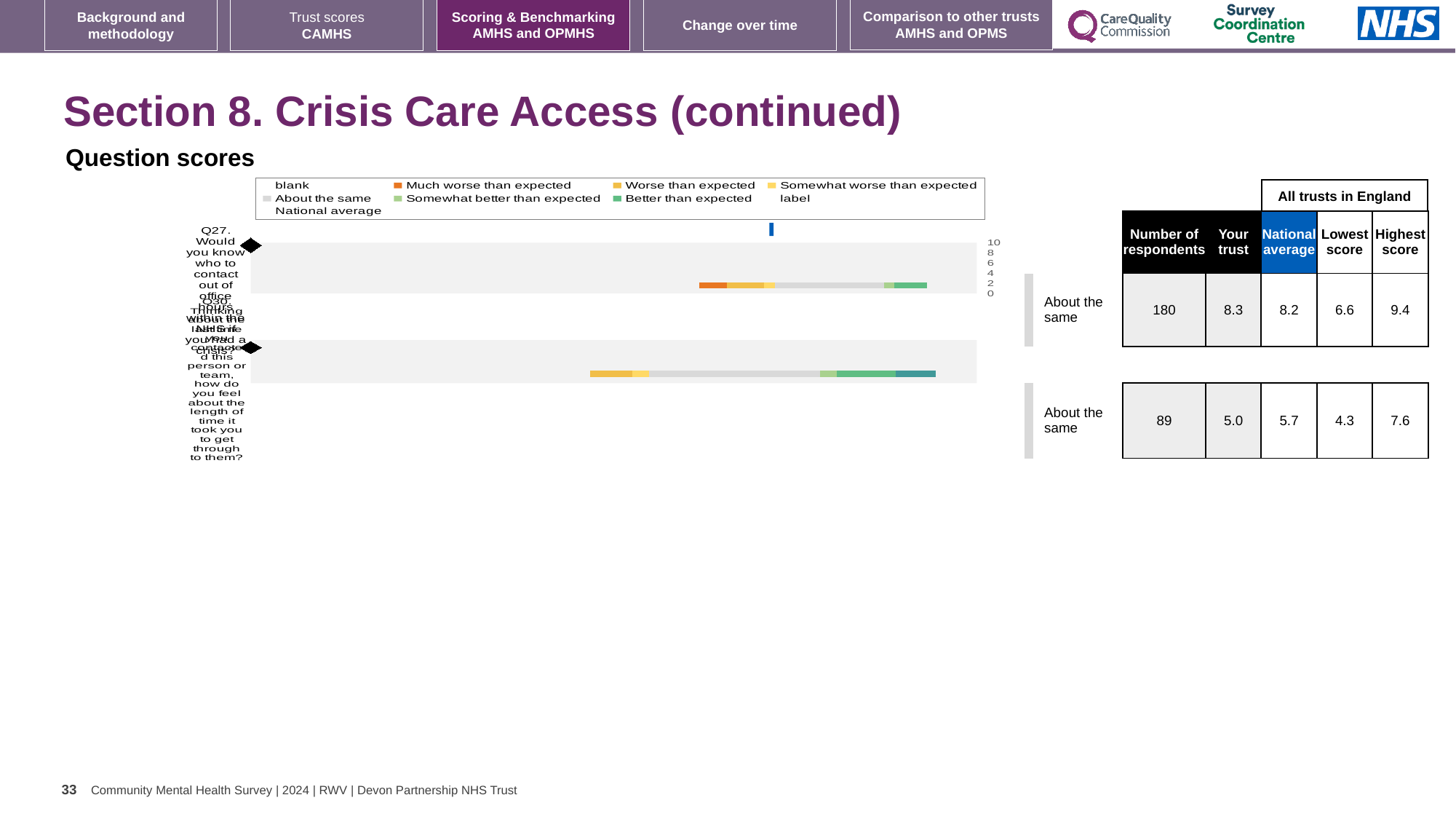
How many questions (categories) are plotted in the chart? 2 For Q27, which is larger in the table beside the chart: the 'Your trust' score or the national average? Your trust What does the dark blue marker in the chart legend represent? National average According to the table beside the chart, what is the 'Your trust' score for Q30? 5.0 What is the difference between the highest score and the lowest score for Q27 in the table beside the chart? 2.8 According to the table beside the chart, what is the national average for Q30? 5.7 According to the table beside the chart, what is the 'Your trust' score for Q27? 8.3 What is the difference between the highest score and the lowest score for Q30 in the table beside the chart? 3.3 In the chart legend, which colour represents 'Much worse than expected'? orange According to the table beside the chart, how many respondents answered Q27? 180 According to the table beside the chart, how many respondents answered Q30? 89 What kind of chart is shown on the slide? bar chart